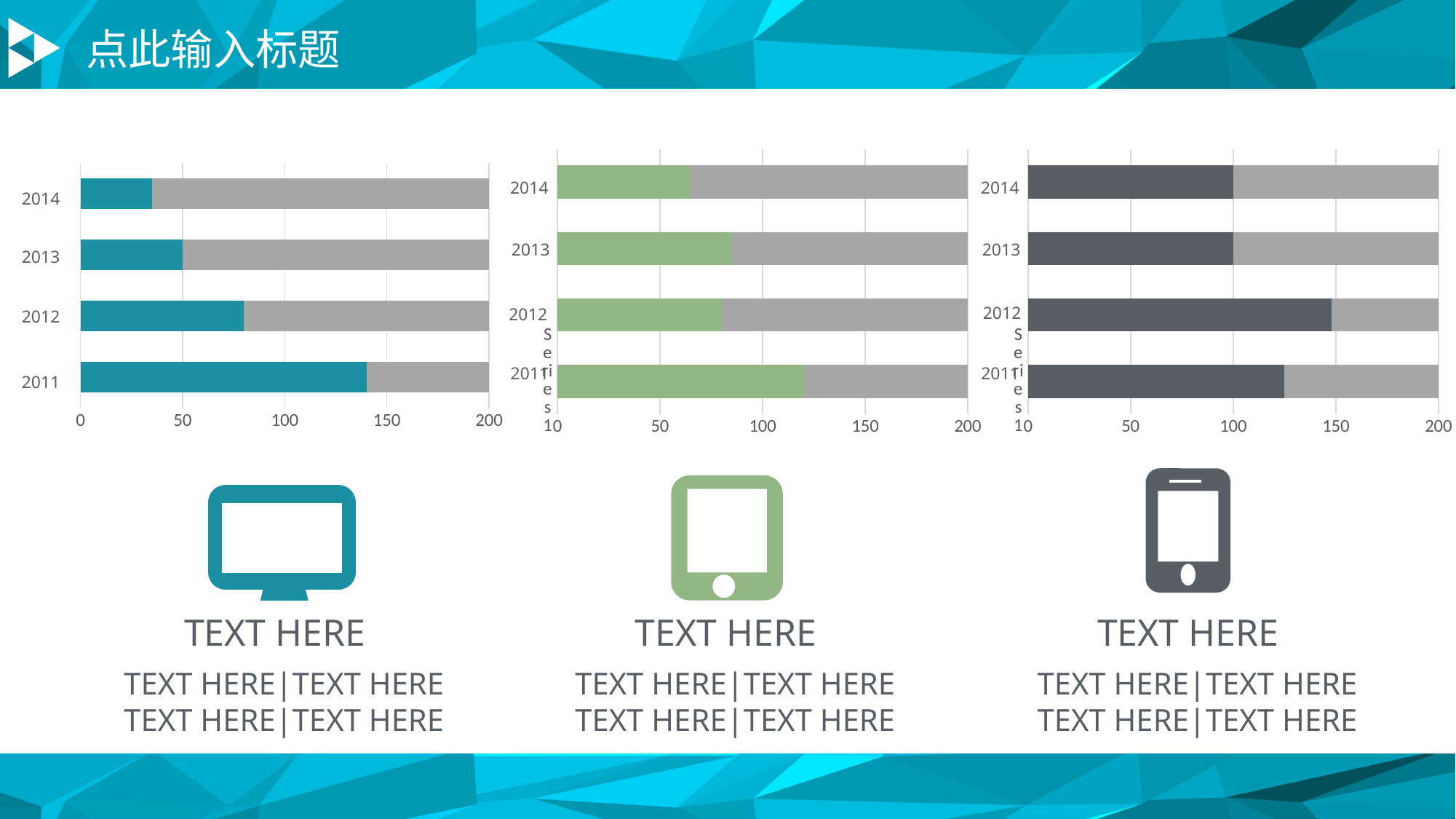
In the left chart, is the teal value for 2014 greater or less than 50? less In the right chart, is the dark grey value for 2012 greater or less than 100? greater In the left chart, which year has the shortest teal bar? 2014 What kind of chart is the left chart? bar chart In the middle chart, is the green value for 2011 greater or less than 100? greater In the right chart, which is larger, the dark grey value for 2012 or for 2011? 2012 In the right chart, which year has the longest dark grey bar? 2012 In the left chart, which year has the longest teal bar? 2011 In the middle chart, which year has the shortest green bar? 2014 In the left chart, how many years are shown on the vertical axis? 4 In the middle chart, which year has the longest green bar? 2011